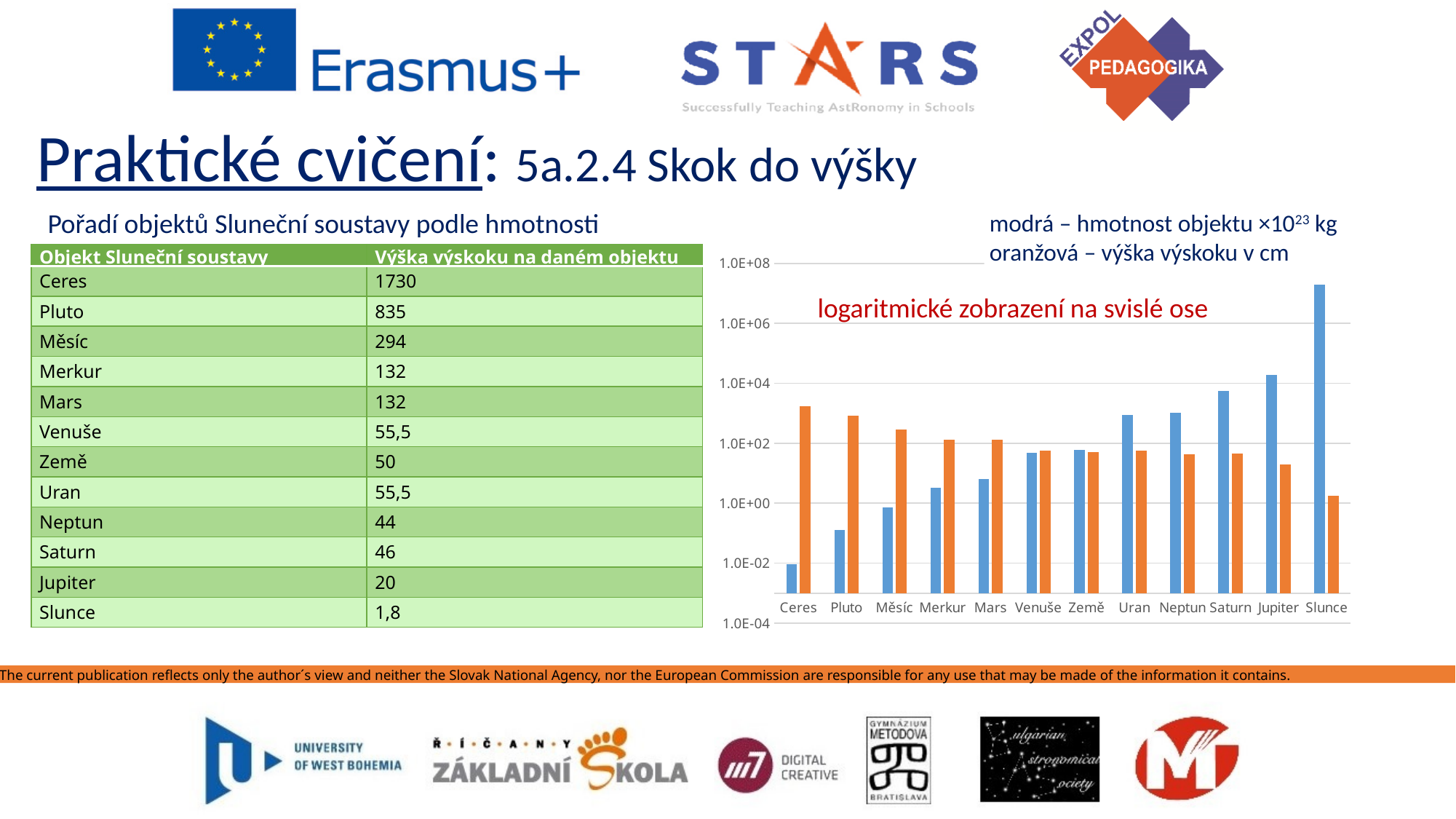
Which object has the lowest orange bar (jump height) in the chart? Slunce Do the blue bars (mass) generally rise or fall from Ceres to Slunce along the x axis? rise Is the blue bar (mass) for Slunce greater or less than 1.0E+06? greater Which object has the highest blue bar (mass) in the chart? Slunce How many objects (categories) are shown on the x axis of the chart? 12 Which object has the highest orange bar (jump height) in the chart? Ceres What kind of chart is shown on the slide? bar chart For Slunce, which bar is taller, the blue one or the orange one? blue Which object has the lowest blue bar (mass) in the chart? Ceres What kind of scale is used on the vertical axis of the chart? logarithmic Is the blue bar (mass) for Ceres greater or less than 1.0E+00? less How many data series does the chart show? 2